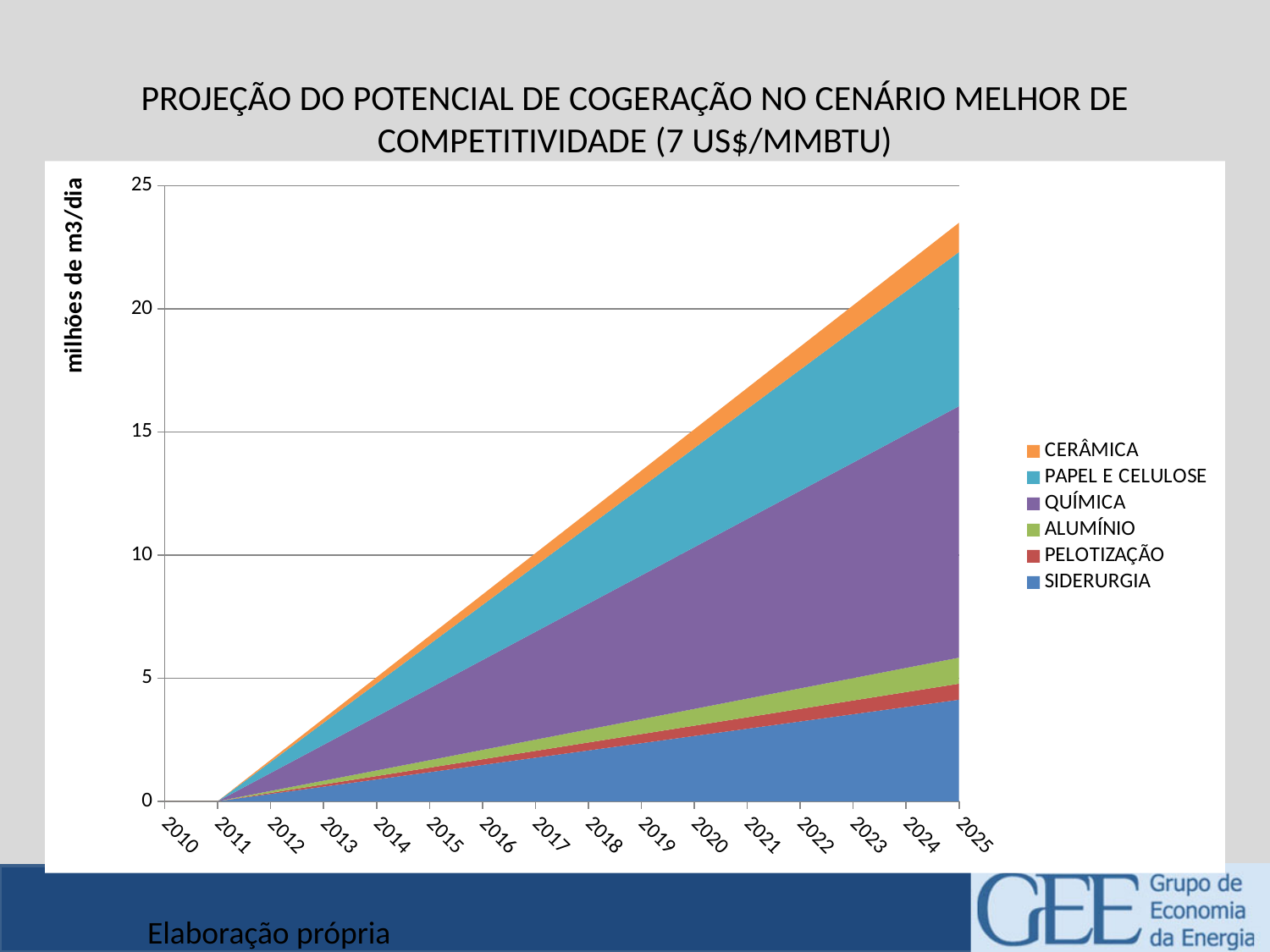
Is the value for SIDERURGIA in 2025 greater or less than 5? less What kind of chart is shown on the slide? Stacked area chart Is the total stacked value for 2015 greater or less than 5? greater Does the total cogeneration potential rise or fall from 2011 to 2025? Rise Is the total stacked value for 2018 greater or less than 10? greater Which series contributes the largest share of the total in 2025? QUÍMICA How many series does the legend list? 6 Which series is listed first in the legend? CERÂMICA How many years are shown on the x axis? 16 Which is larger in 2025, the QUÍMICA area or the CERÂMICA area? QUÍMICA What is the label of the y axis? milhões de m3/dia